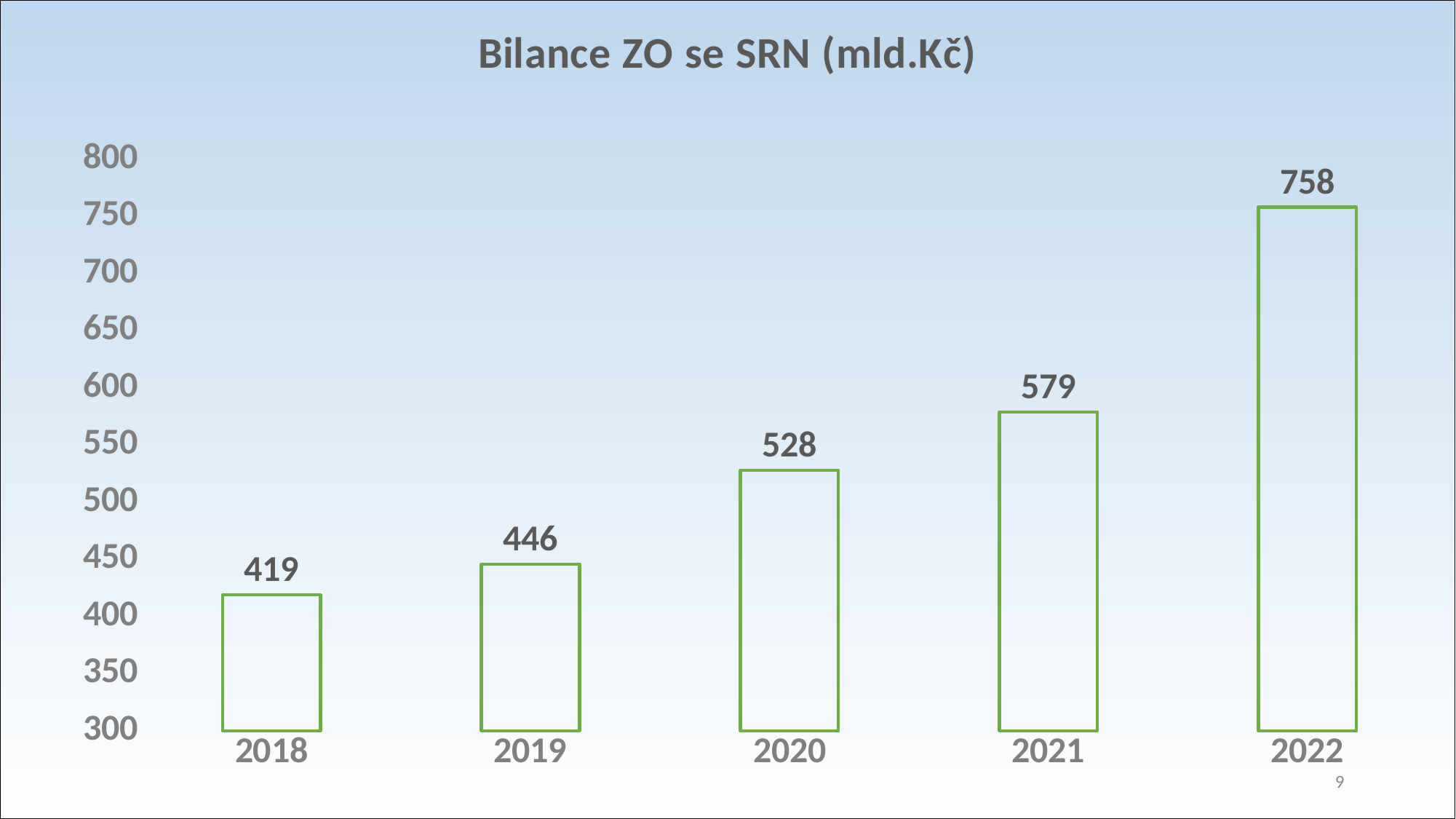
How many years are shown on the x axis? 5 Which year has the lowest value? 2018 What is the value for 2022? 758 Which year has the highest value? 2022 What is the value for 2020? 528 What kind of chart is shown on the slide? bar chart Which is larger, the value for 2020 or the value for 2021? 2021 Do the values rise or fall from 2018 to 2022? rise Is the value for 2021 greater or less than 550? greater What is the difference between the values for 2022 and 2021? 179 What is the difference between the values for 2019 and 2018? 27 What is the value for 2018? 419